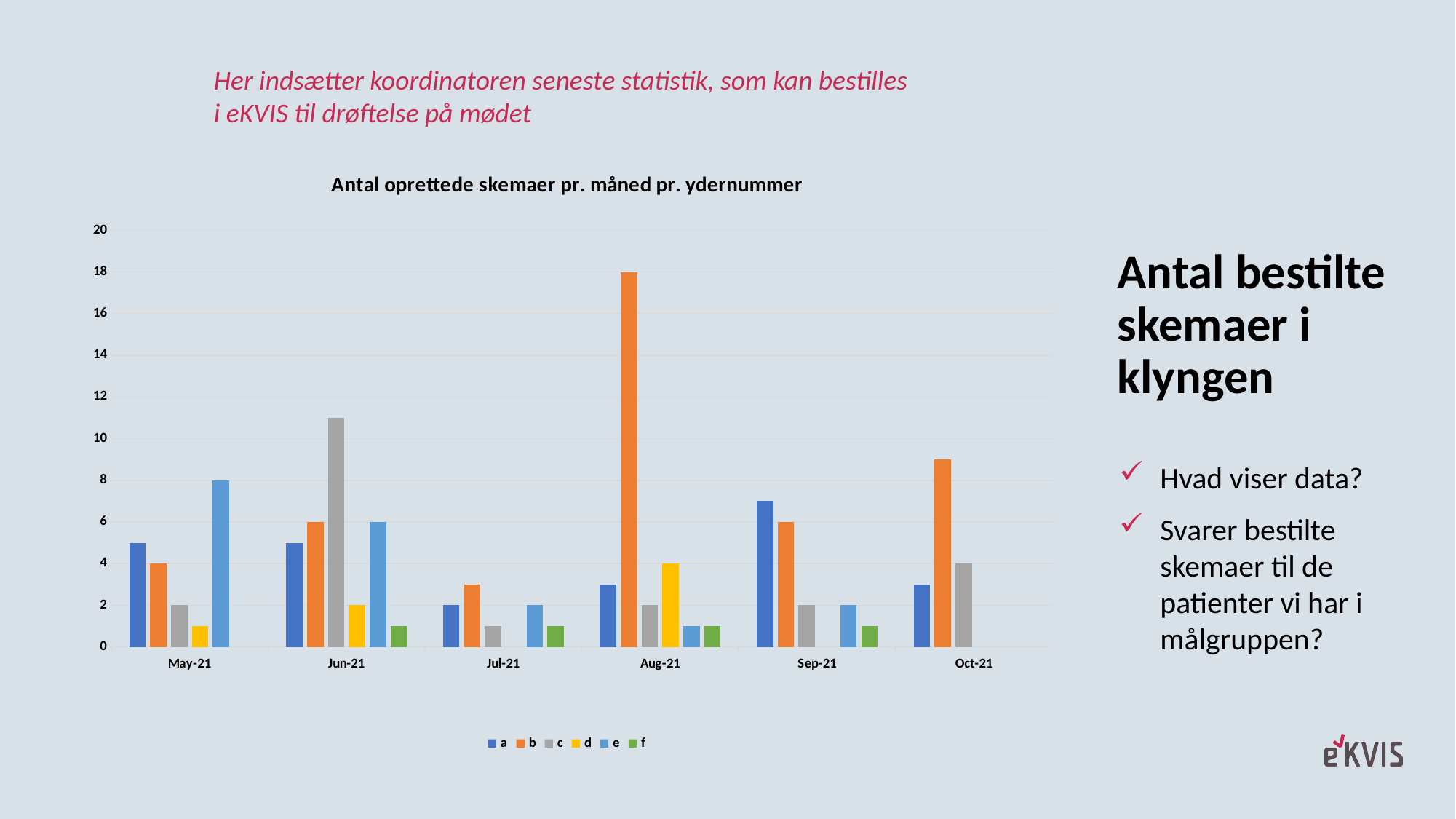
What is the value for series e in May-21? 8 What is the value for series d in Aug-21? 4 What is the title of the chart? Antal oprettede skemaer pr. måned pr. ydernummer Is the value for series a in Sep-21 greater or less than 10? less Is the value for series c in Jun-21 greater or less than 10? greater How many months are shown on the x axis? 6 What is the difference between series b in Aug-21 and series e in May-21? 10 In which month does series b reach its highest value? Aug-21 How many series does the legend list? 6 What kind of chart is shown on the slide? bar chart In Jun-21, which is larger: series b or series c? c What is the value for series b in Aug-21? 18